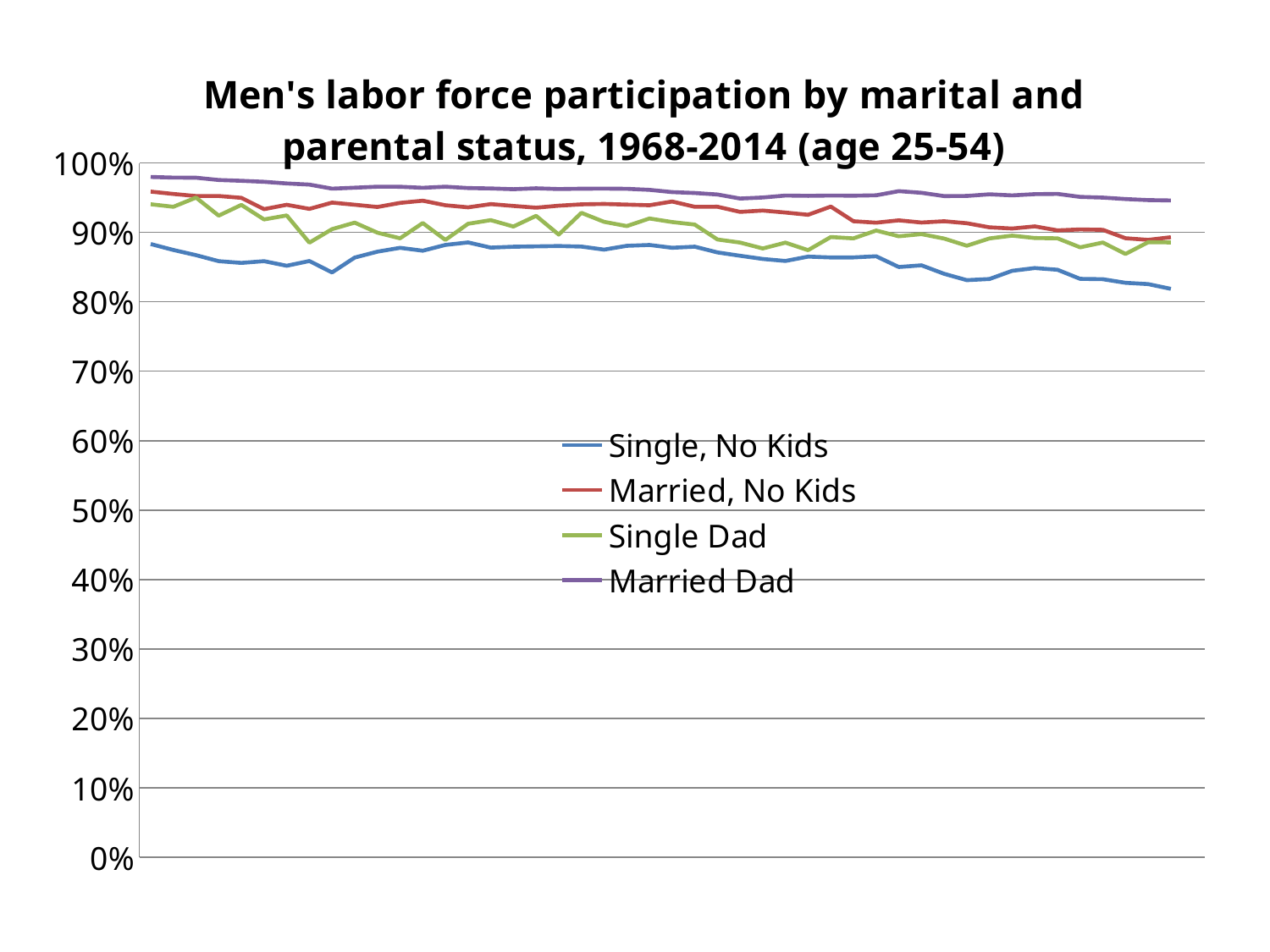
Which series has the highest labor force participation throughout the period? Married Dad Is the value for Married Dad greater or less than 90% across the whole period? greater How many series does the legend list? 4 Which series is drawn in blue? Single, No Kids Is the value for Single, No Kids greater or less than 80% at the end of the period? greater Does the Married Dad line rise or fall overall from left to right? fall What kind of chart is shown on the slide? line chart Is the value for Single, No Kids greater or less than 90% across the whole period? less What is the title of the chart? Men's labor force participation by marital and parental status, 1968-2014 (age 25-54) Which is higher at the end of the period, Married Dad or Single, No Kids? Married Dad Does the Single, No Kids line rise or fall overall from left to right? fall Which series has the lowest labor force participation throughout the period? Single, No Kids